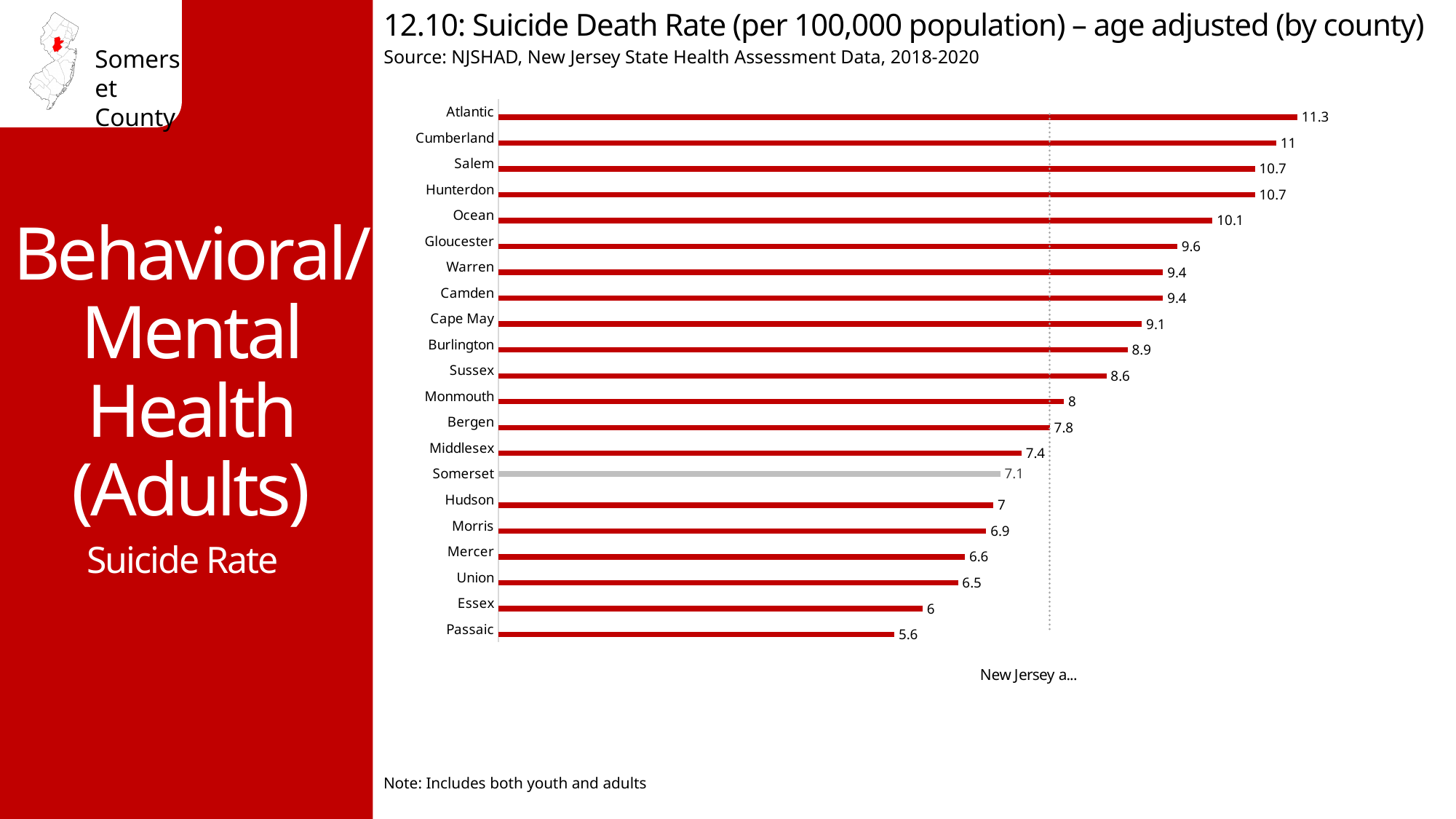
What is the difference between the suicide death rates of Atlantic and Passaic counties? 5.7 What type of chart is shown on the slide? Bar chart How many counties are shown in the chart? 21 Which county has the highest suicide death rate? Atlantic What is the suicide death rate for Atlantic County? 11.3 What is the difference between the suicide death rates of Middlesex and Somerset counties? 0.3 Which county has the lowest suicide death rate? Passaic Which county has a higher suicide death rate, Ocean or Gloucester? Ocean What is the suicide death rate for Passaic County? 5.6 Which county has a higher suicide death rate, Bergen or Hudson? Bergen What is the suicide death rate for Somerset County? 7.1 Which county's bar is shown in gray instead of red? Somerset